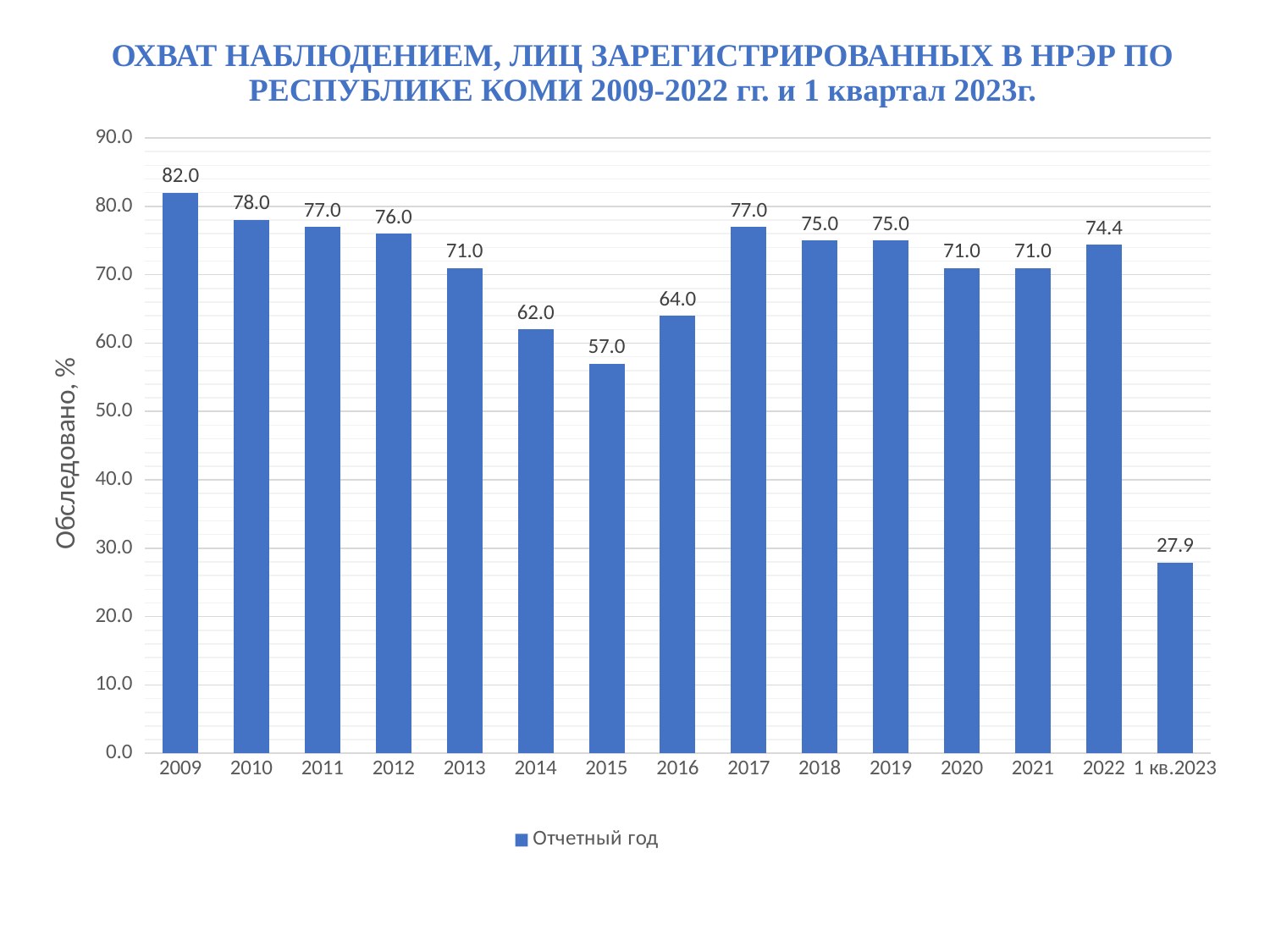
Which category has the lowest value? 1 кв.2023 Which category has the highest value? 2009 What kind of chart is this? bar chart What is the difference between the values for 2009 and 2015? 25.0 What is the value for 2015? 57.0 What is the value for 2022? 74.4 What is the value for 1 кв.2023? 27.9 What is the value for 2009? 82.0 How many categories are shown on the x axis? 15 What is the y-axis title? Обследовано, % How many series does the legend list? 1 Which is larger, the value for 2014 or the value for 2016? 2016